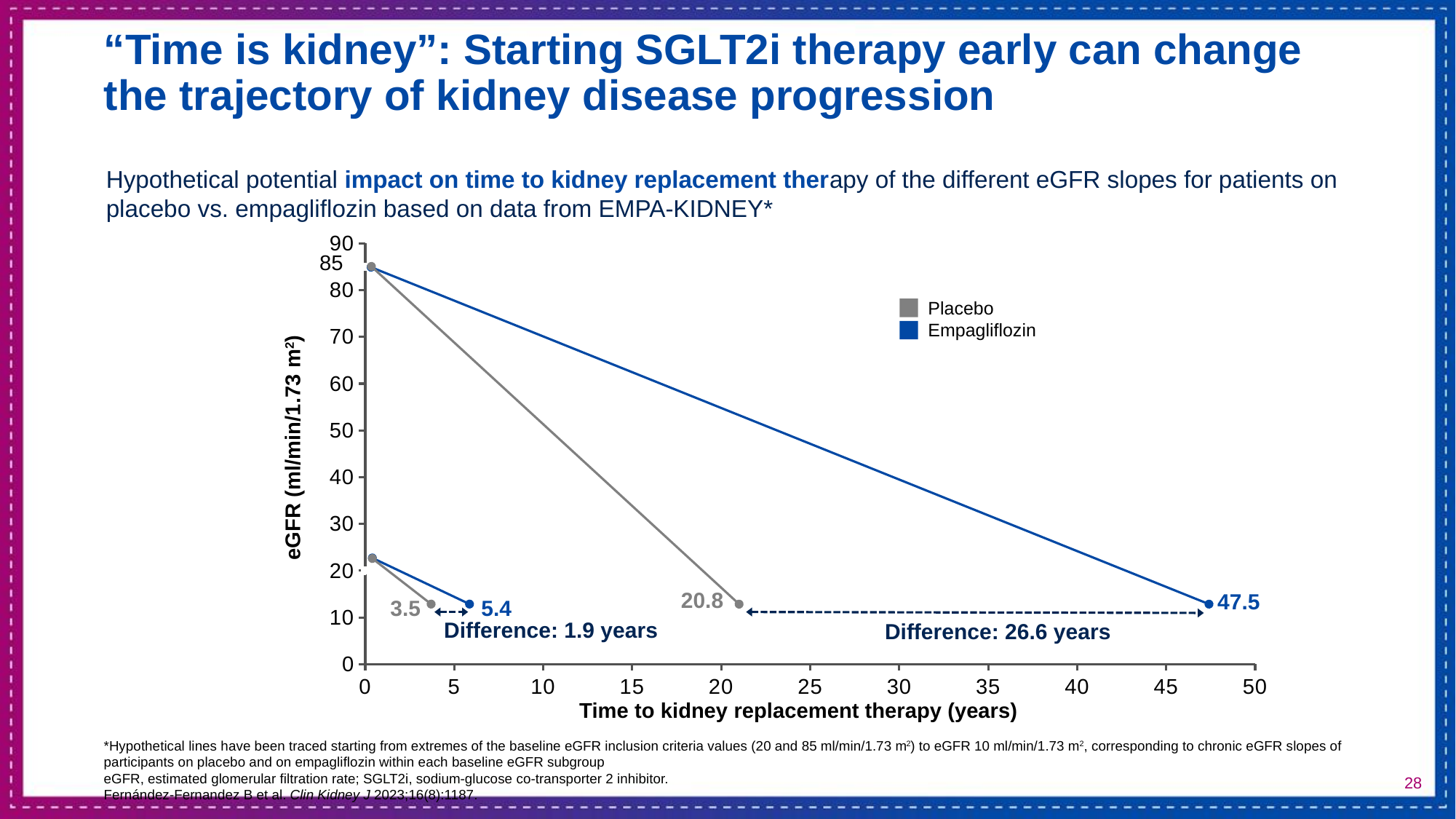
What is the time to kidney replacement therapy (years) for the placebo line starting from the lower baseline eGFR? 3.5 How many series does the legend list? 2 What kind of chart is shown on the slide? line chart What is the time to kidney replacement therapy (years) for the empagliflozin line starting from eGFR 85? 47.5 What is the time to kidney replacement therapy (years) for the empagliflozin line starting from the lower baseline eGFR? 5.4 What is the time to kidney replacement therapy (years) for the placebo line starting from eGFR 85? 20.8 Do the eGFR values rise or fall along the x axis for each line? fall What is the difference in years between the empagliflozin and placebo lines starting from the lower baseline eGFR? 1.9 years Which two series are listed in the legend? Placebo and Empagliflozin What is the difference in years between the empagliflozin and placebo lines starting from eGFR 85? 26.6 years Which labelled time to kidney replacement therapy is the largest on the chart? 47.5 Which series reaches kidney replacement therapy later when starting from eGFR 85, placebo or empagliflozin? Empagliflozin